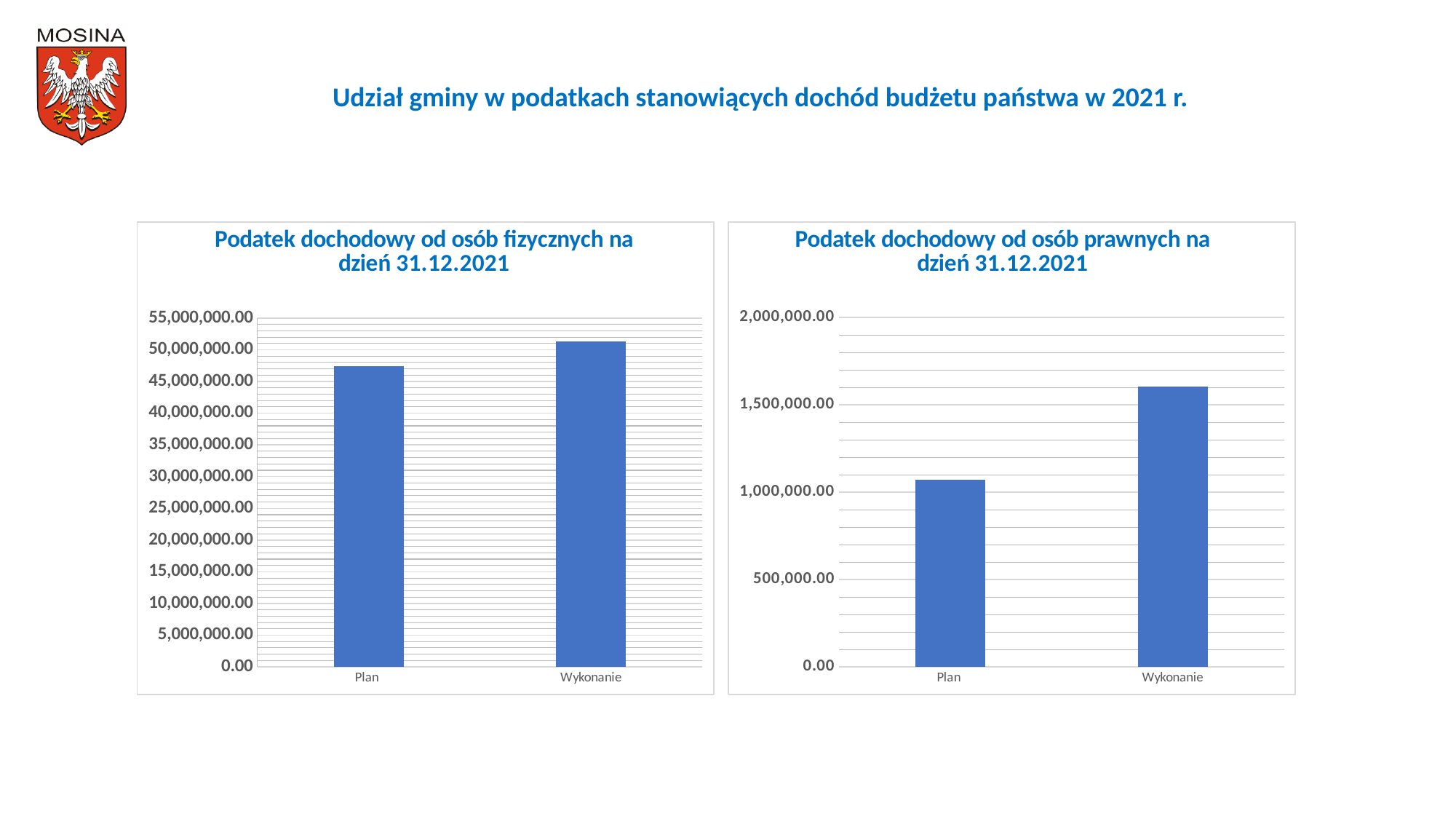
In the left chart (osób fizycznych), is the value for Plan greater or less than 45,000,000.00? greater What is the title of the chart on the right side of the slide? Podatek dochodowy od osób prawnych na dzień 31.12.2021 In the right chart (osób prawnych), is the value for Wykonanie greater or less than 2,000,000.00? less In the right chart (osób prawnych), is the value for Plan greater or less than 1,500,000.00? less In the chart titled "Podatek dochodowy od osób prawnych na dzień 31.12.2021", which category has the lower value? Plan In the chart titled "Podatek dochodowy od osób fizycznych na dzień 31.12.2021", which category has the higher value, Plan or Wykonanie? Wykonanie How many categories are shown on the x axis of the chart titled "Podatek dochodowy od osób prawnych na dzień 31.12.2021"? 2 What kind of chart is the left chart, "Podatek dochodowy od osób fizycznych na dzień 31.12.2021"? bar chart